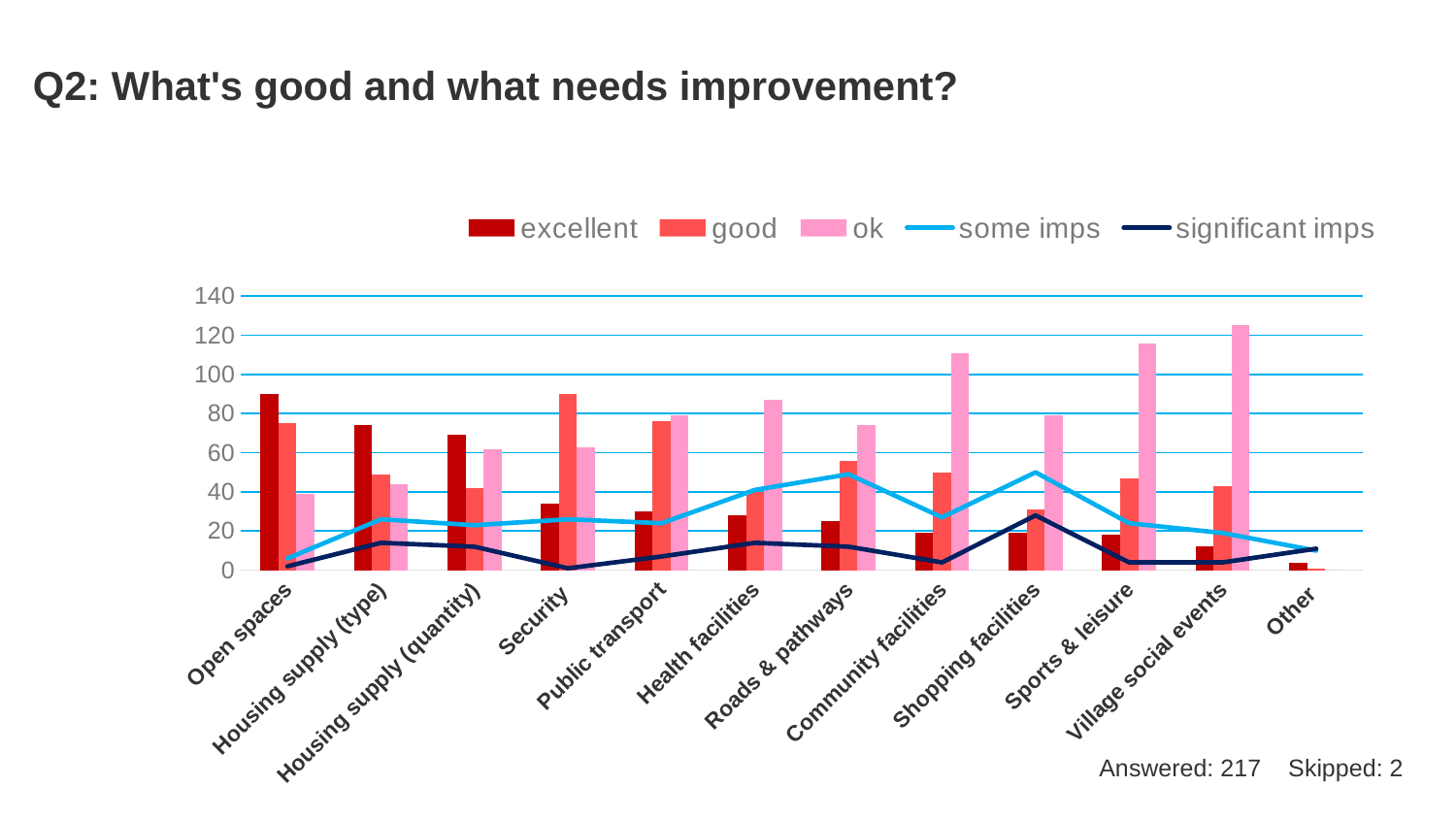
How many series does the legend list? 5 Which category has the highest 'excellent' bar? Open spaces Does the 'some imps' line rise or fall from Shopping facilities to Other? It falls Is the 'ok' value for Community facilities greater or less than 100? greater What is the title of the chart? Q2: What's good and what needs improvement? Is the 'excellent' value for Security greater or less than 40? less Which category has the lowest 'ok' bar? Other For Open spaces, which is larger: the 'excellent' bar or the 'ok' bar? excellent Which category has the highest 'good' bar? Security Which category has the highest 'ok' bar? Village social events What kind of chart is shown on the slide? A combined bar and line chart How many categories are shown along the x axis? 12